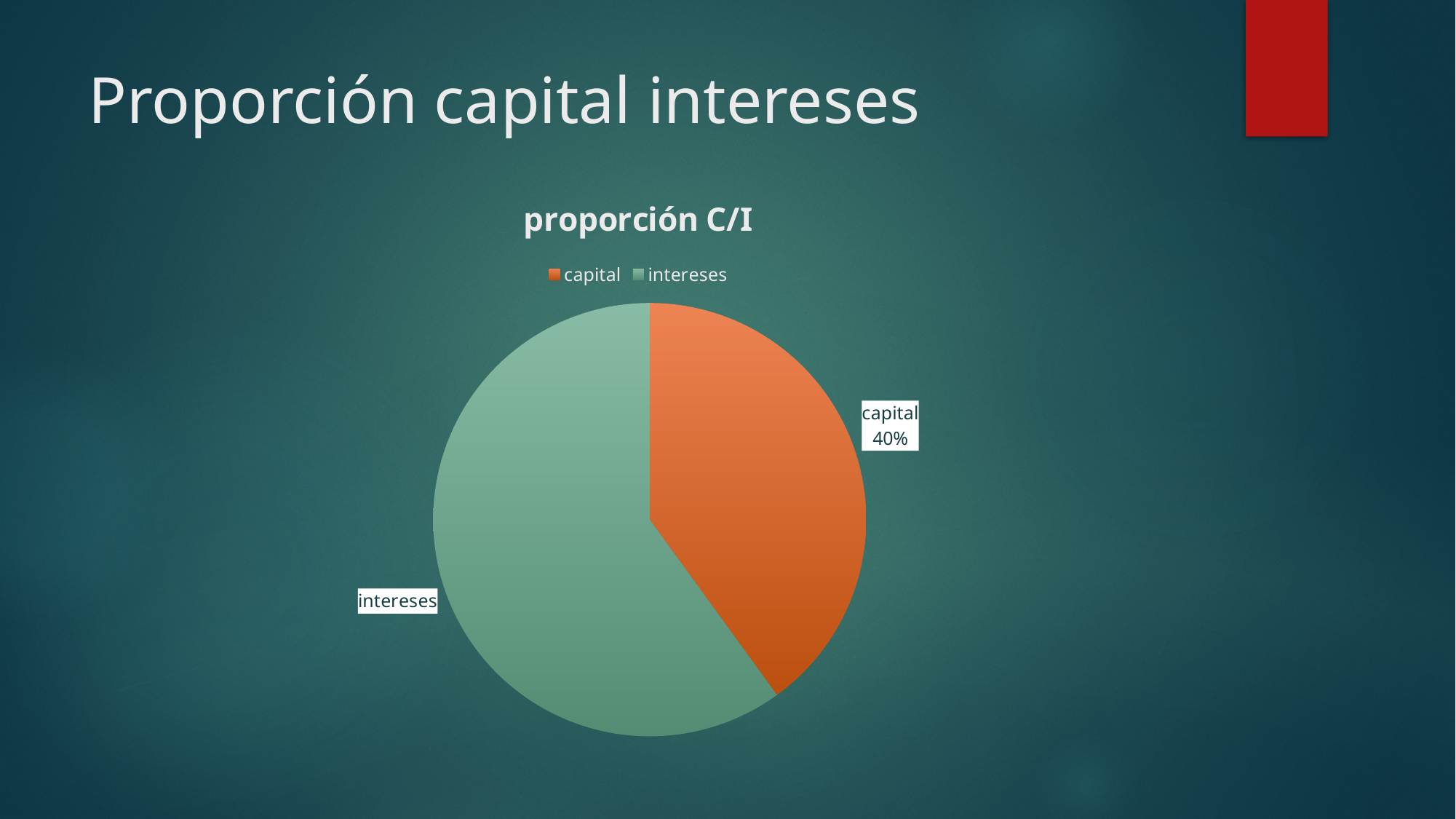
What kind of chart is shown on the slide? pie chart What share of the pie does capital represent? 40% How many slices does the pie chart have? 2 Which is larger, the capital slice or the intereses slice? intereses Which slice is the largest in the pie chart? intereses What colour is the capital slice? orange What is the title of the chart? proporción C/I How many series does the legend list? 2 Is the share for intereses greater or less than 50%? greater Which slice is the smallest in the pie chart? capital Is the share for capital greater or less than 50%? less